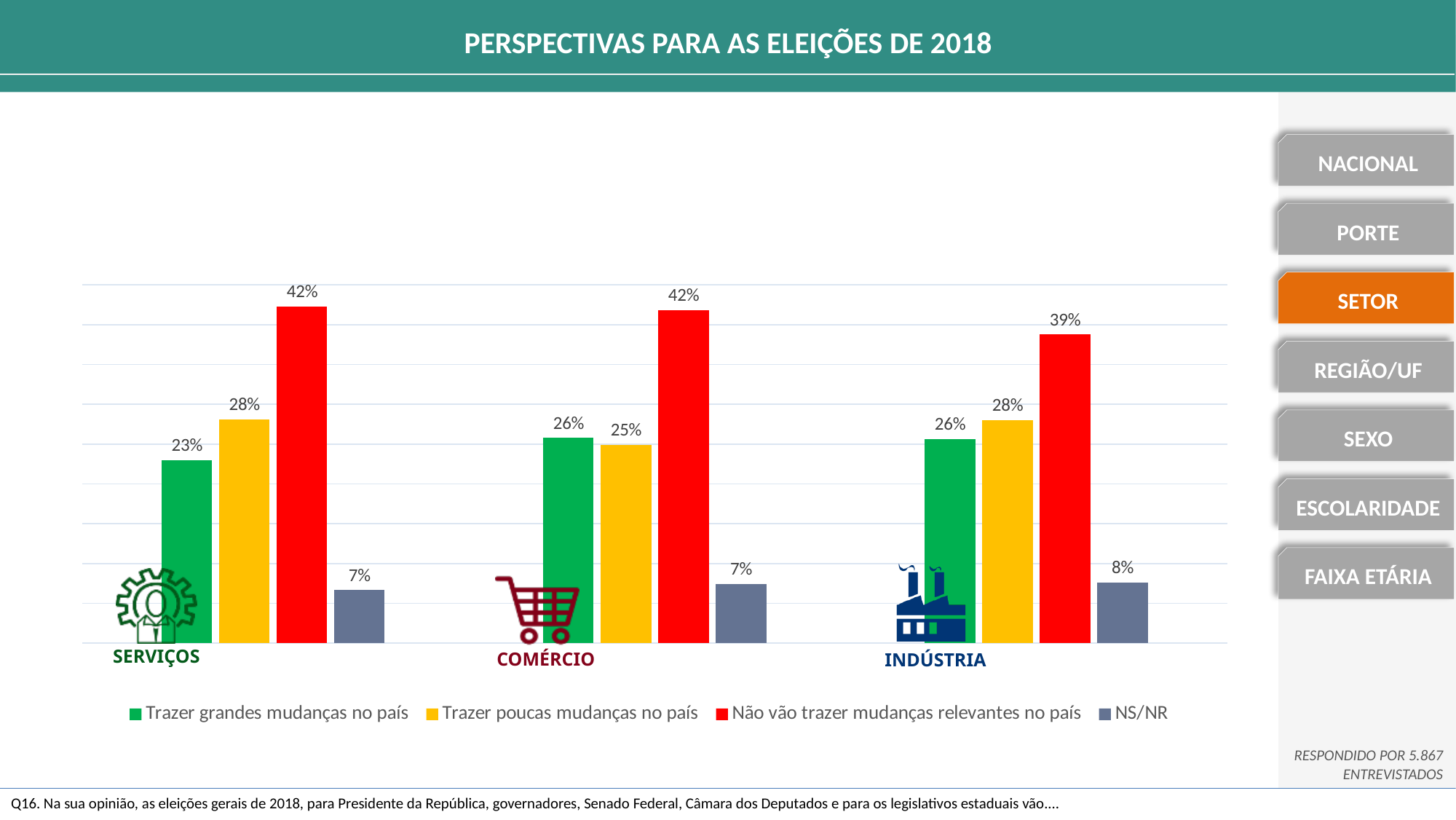
What is the difference between "Não vão trazer mudanças relevantes no país" and "Trazer grandes mudanças no país" for SERVIÇOS? 19% What is the value for "Não vão trazer mudanças relevantes no país" in the SERVIÇOS category? 42% What is the value for "Trazer grandes mudanças no país" in the INDÚSTRIA category? 26% What is the NS/NR value for INDÚSTRIA? 8% How many categories are shown on the x axis? 3 How many series does the legend list? 4 In the COMÉRCIO category, which is larger: "Trazer grandes mudanças no país" or "Trazer poucas mudanças no país"? Trazer grandes mudanças no país Which category has the lowest value for "Não vão trazer mudanças relevantes no país"? INDÚSTRIA Which category has the lowest value for "Trazer grandes mudanças no país"? SERVIÇOS What is the value for "Trazer poucas mudanças no país" in the COMÉRCIO category? 25% What kind of chart is shown on the slide? Bar chart Which colour represents the NS/NR series in the legend? Grey